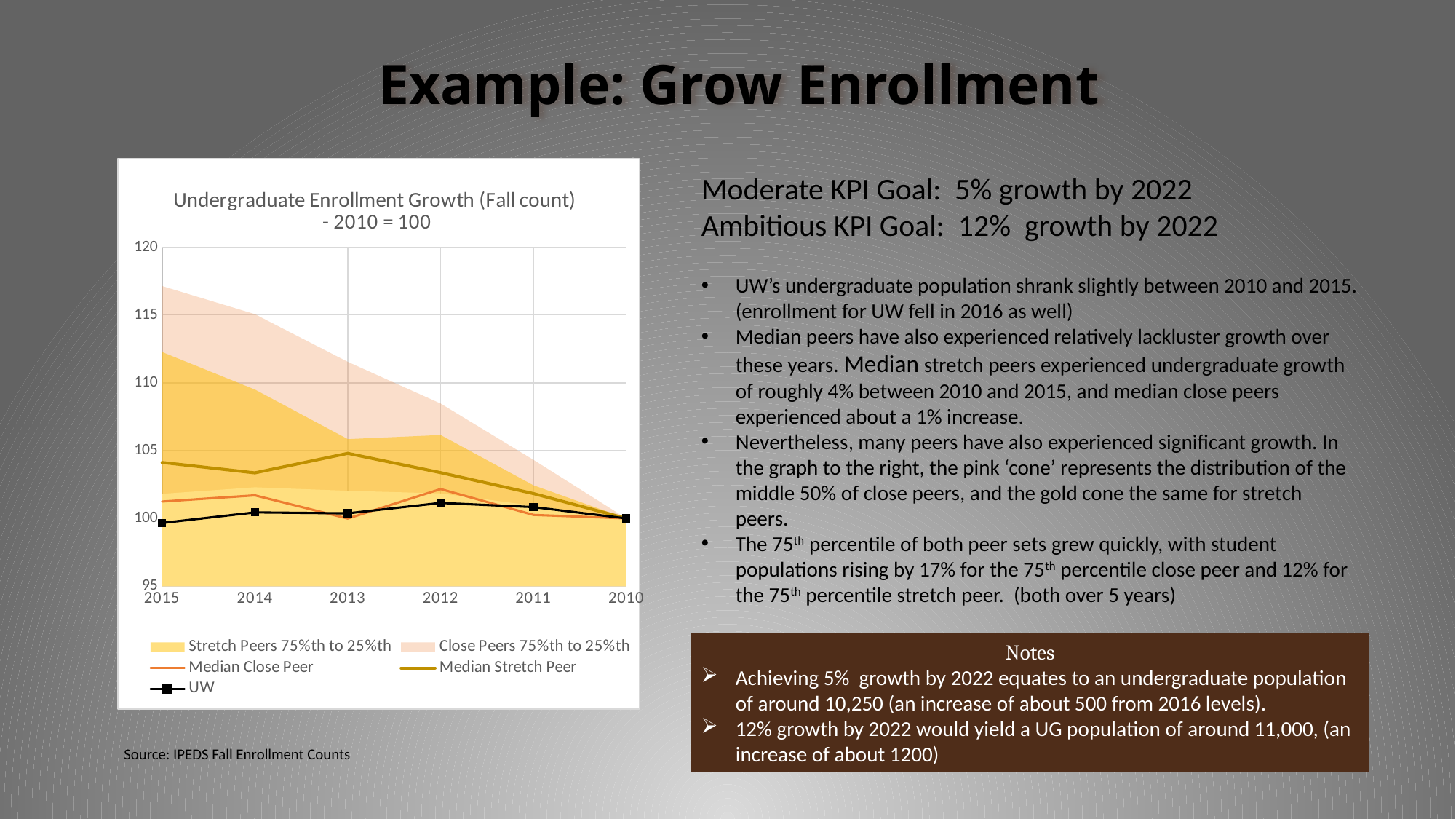
Does the Median Stretch Peer line rise or fall from 2010 to 2015? rise What is the title of the chart? Undergraduate Enrollment Growth (Fall count) - 2010 = 100 Is the upper edge of the Stretch Peers 75%th to 25%th band in 2015 greater or less than 110? greater In 2015, which is higher: the Median Stretch Peer line or the Median Close Peer line? Median Stretch Peer How many series does the chart's legend list? 5 Which of the three plotted lines has the highest value in 2015? Median Stretch Peer How many years are shown on the x axis of the chart? 6 In 2015, which is higher: the Median Stretch Peer line or the UW line? Median Stretch Peer Is the Median Stretch Peer value in 2015 greater or less than 100? greater What is the lowest value shown on the chart's y axis? 95 Is the upper edge of the Close Peers 75%th to 25%th band in 2015 greater or less than 115? greater What is the value of the UW series in 2010? 100